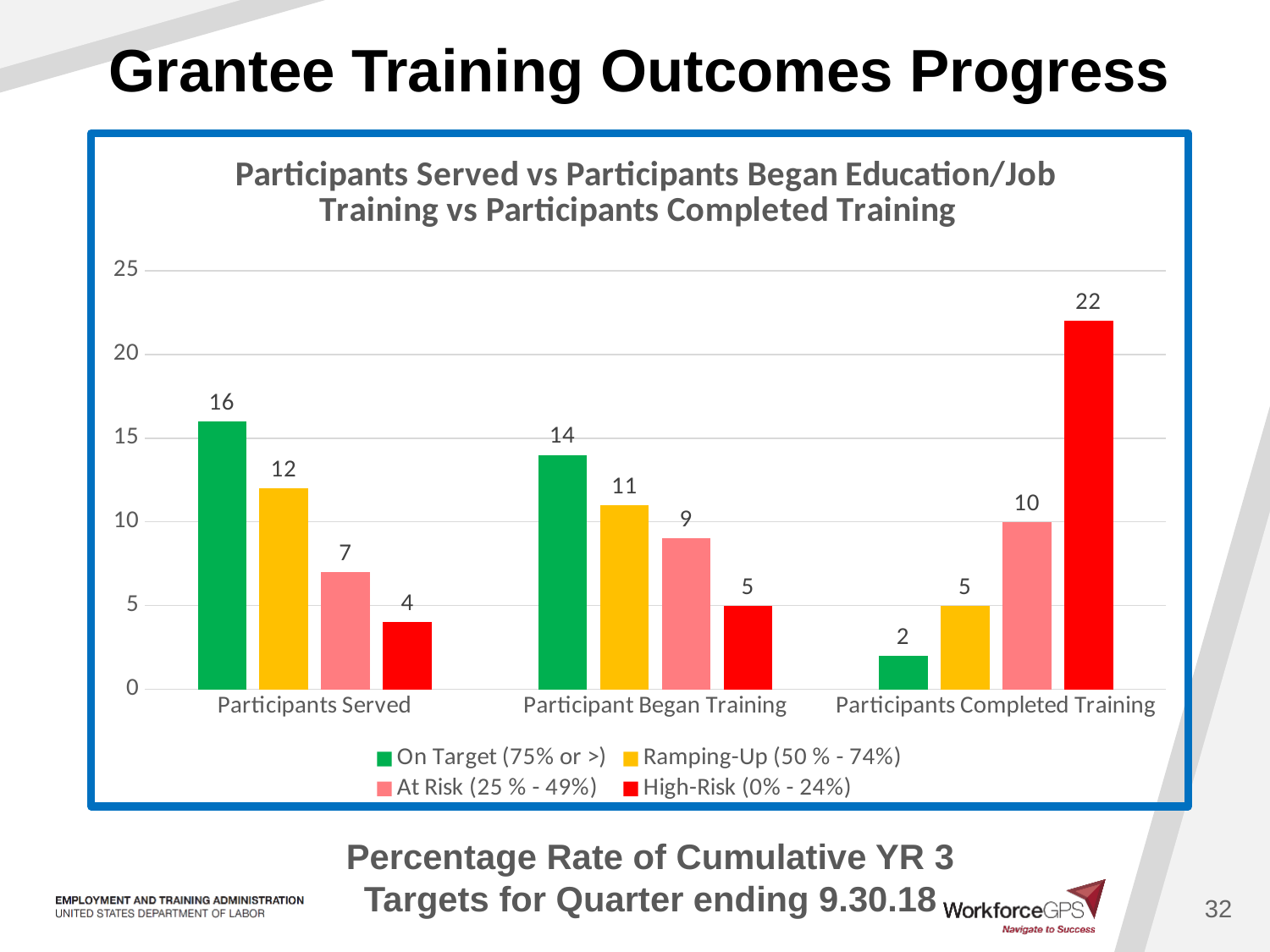
How many categories are shown on the x axis? 3 Which is larger: the Ramping-Up value for Participants Served or the Ramping-Up value for Participant Began Training? Participants Served What is the value for High-Risk (0% - 24%) in the Participants Completed Training category? 22 What is the value for At Risk (25 % - 49%) in the Participant Began Training category? 9 What is the difference between the On Target value for Participants Served and the On Target value for Participants Completed Training? 14 What colour represents the At Risk (25 % - 49%) series? pink What kind of chart is shown on the slide? bar chart Is the High-Risk value for Participants Completed Training greater or less than 20? greater Which series has the lowest value in the Participants Served category? High-Risk (0% - 24%) Which series has the highest value in the Participants Completed Training category? High-Risk (0% - 24%) How many series does the legend list? 4 What is the value for On Target (75% or >) in the Participants Served category? 16